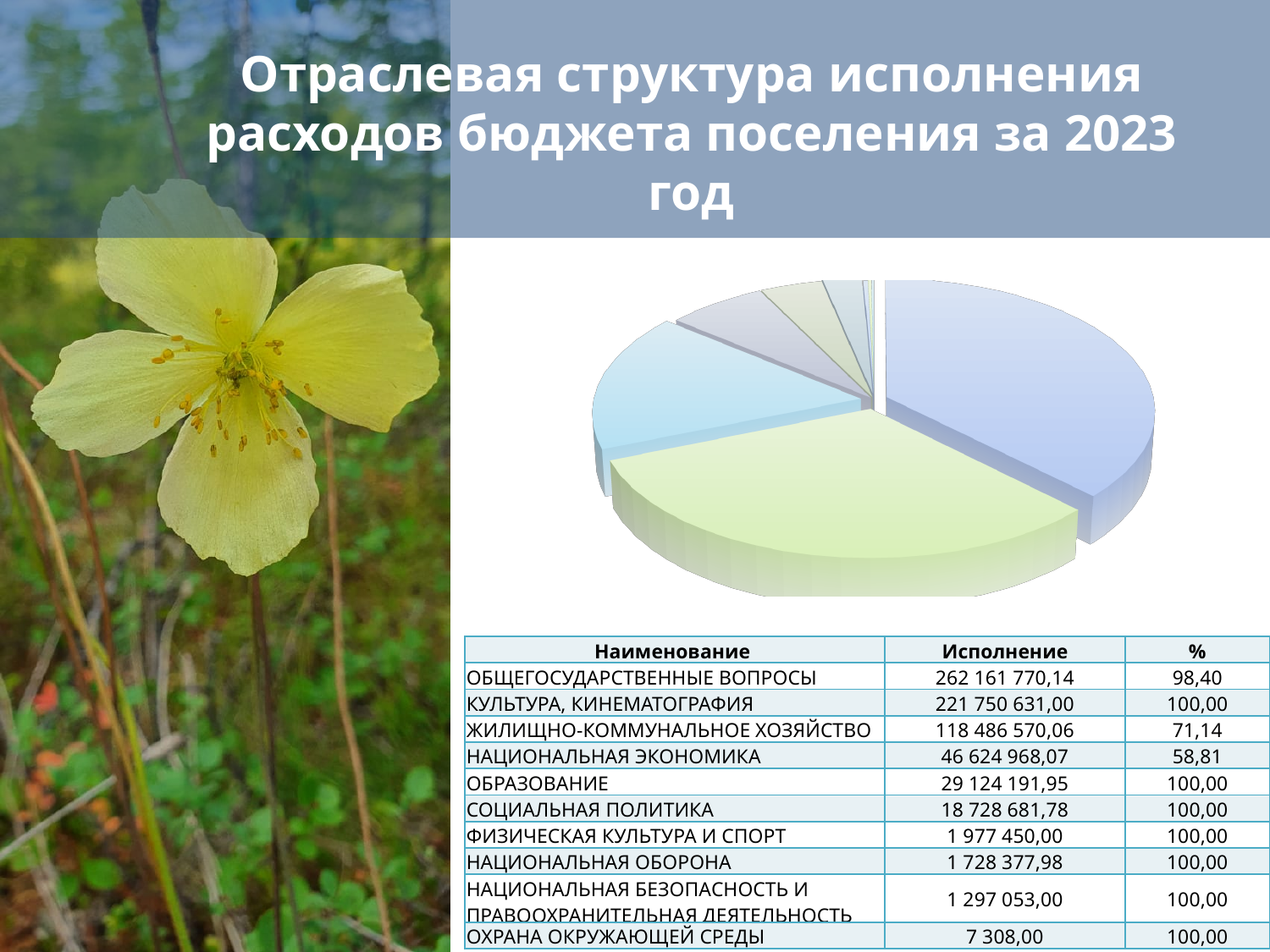
According to the data table under the chart, what is the Исполнение value for ОХРАНА ОКРУЖАЮЩЕЙ СРЕДЫ? 7 308,00 According to the data table under the chart, what is the % value for НАЦИОНАЛЬНАЯ ЭКОНОМИКА? 58,81 According to the data table under the chart, what is the % value for ЖИЛИЩНО-КОММУНАЛЬНОЕ ХОЗЯЙСТВО? 71,14 Which has the larger Исполнение value in the data table: НАЦИОНАЛЬНАЯ ЭКОНОМИКА or ОБРАЗОВАНИЕ? НАЦИОНАЛЬНАЯ ЭКОНОМИКА How many categories are listed in the data table under the chart? 10 What is the title of the slide containing the pie chart? Отраслевая структура исполнения расходов бюджета поселения за 2023 год Which category has the lowest % value in the data table under the chart? НАЦИОНАЛЬНАЯ ЭКОНОМИКА Which category has the highest Исполнение value in the data table under the chart? ОБЩЕГОСУДАРСТВЕННЫЕ ВОПРОСЫ Which category has the lowest Исполнение value in the data table under the chart? ОХРАНА ОКРУЖАЮЩЕЙ СРЕДЫ According to the data table under the chart, what is the Исполнение value for КУЛЬТУРА, КИНЕМАТОГРАФИЯ? 221 750 631,00 What kind of chart is shown on the slide? pie chart What is the difference between the Исполнение values for ОБЩЕГОСУДАРСТВЕННЫЕ ВОПРОСЫ and КУЛЬТУРА, КИНЕМАТОГРАФИЯ in the data table? 40 411 139,14